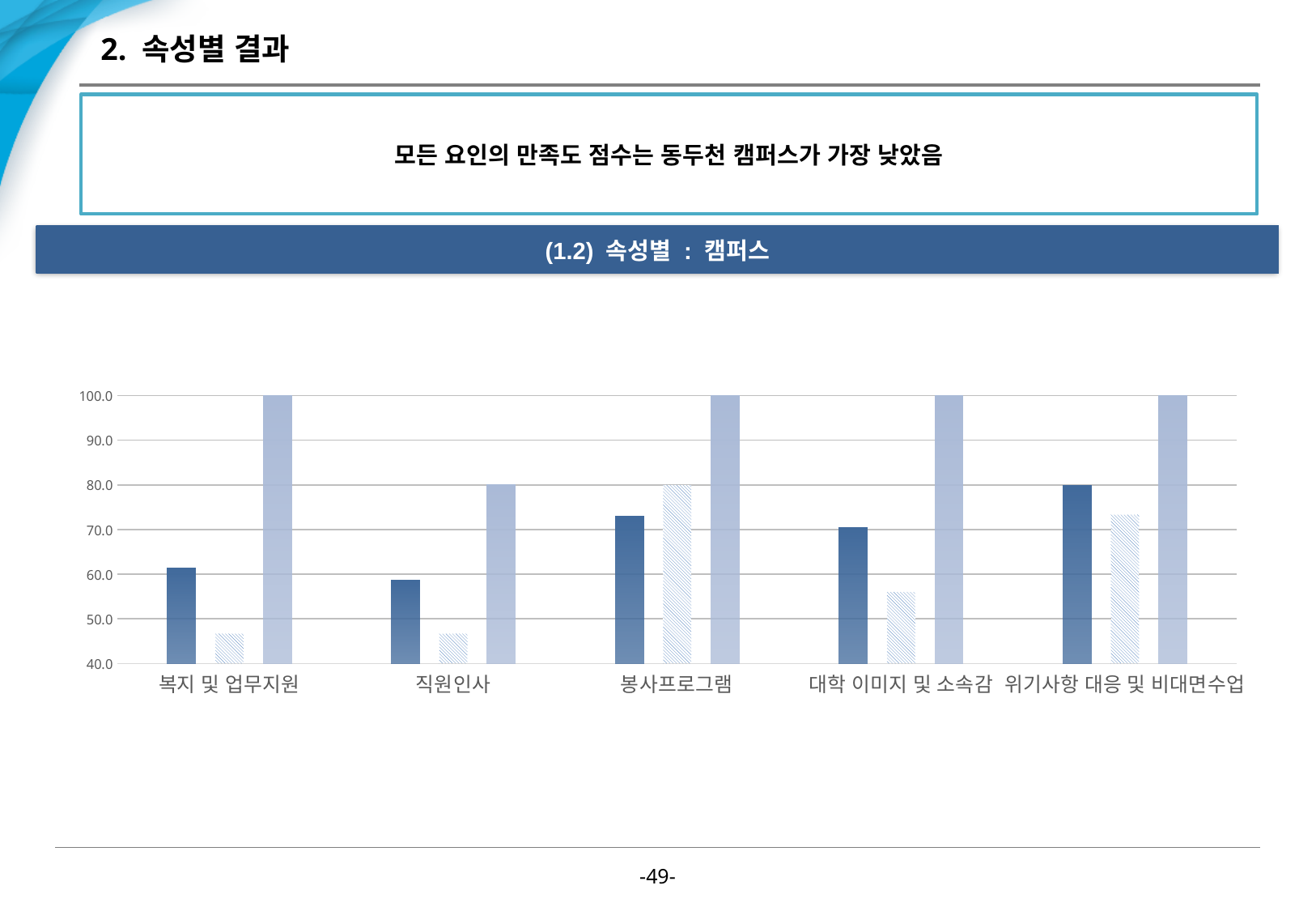
For 봉사프로그램, which is larger: the dark blue bar or the hatched bar? the hatched bar How many bars are plotted for each category in the chart? 3 Among the dark blue (leftmost) bars, which category has the lowest value? 직원인사 How many categories are shown on the x axis of the chart? 5 What is the value of the light blue (rightmost) bar for 복지 및 업무지원? 100.0 What kind of chart is shown on the slide? bar chart Is the value of the hatched (middle) bar for 직원인사 greater or less than 50.0? less What is the value of the light blue (rightmost) bar for 직원인사? 80.0 Among the dark blue (leftmost) bars, which category has the highest value? 위기사항 대응 및 비대면수업 What is the difference between the light blue bar for 복지 및 업무지원 and the light blue bar for 직원인사? 20.0 What is the value of the hatched (middle) bar for 봉사프로그램? 80.0